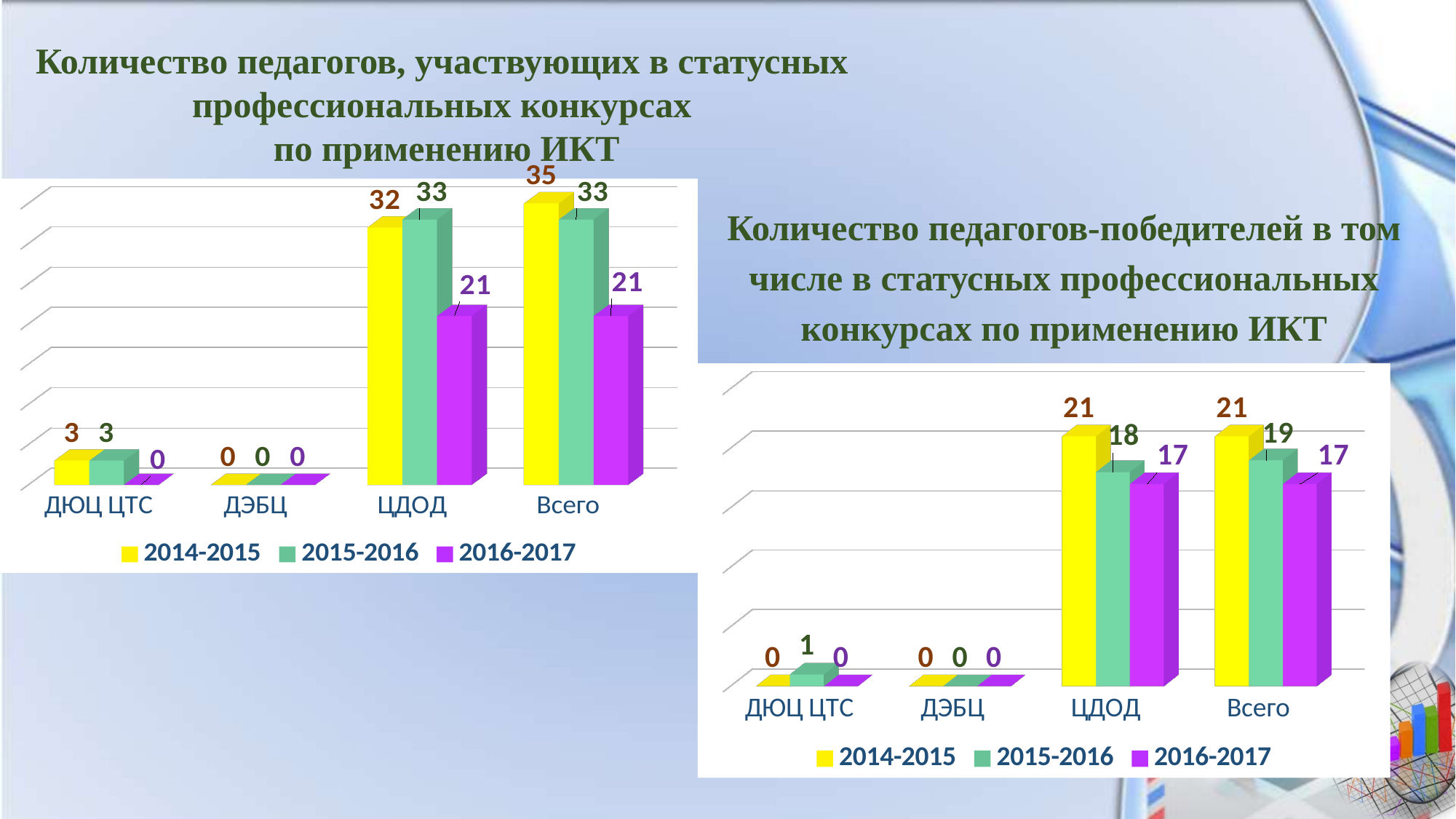
In the right chart, what is the value for ДЮЦ ЦТС in 2015-2016? 1 In the left chart, what is the value for ДЮЦ ЦТС in 2016-2017? 0 In the right chart, what is the difference between the 2014-2015 and 2015-2016 values for ЦДОД? 3 In the left chart, which category has the highest value for 2014-2015? Всего In the right chart (Количество педагогов-победителей), what is the value for ЦДОД in 2015-2016? 18 In the left chart, what is the value for Всего in 2014-2015? 35 In the right chart, which is larger for Всего: the 2014-2015 value or the 2016-2017 value? 2014-2015 In the left chart (Количество педагогов, участвующих в статусных профессиональных конкурсах по применению ИКТ), what is the value for ЦДОД in 2015-2016? 33 In the left chart, how many series does the legend list? 3 In the left chart, what is the difference between the 2014-2015 and 2016-2017 values for Всего? 14 What type of chart is the right chart? Bar chart How many categories are shown on the x axis of the right chart? 4